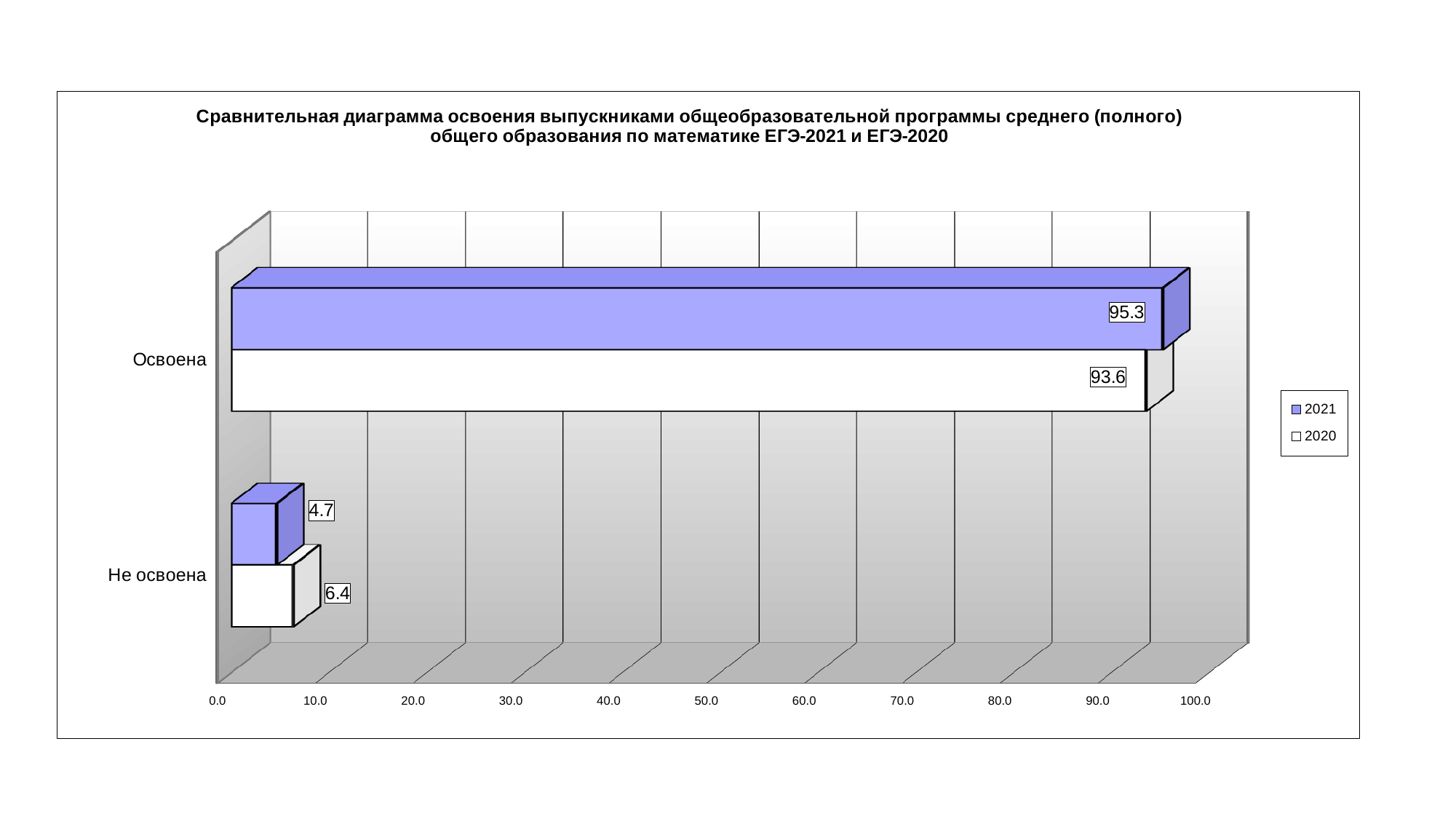
What is the value for 2021 in the "Освоена" category? 95.3 What is the value for 2020 in the "Освоена" category? 93.6 What is the difference between the 2020 and 2021 values in the "Не освоена" category? 1.7 What is the value for 2020 in the "Не освоена" category? 6.4 Which series has the higher value in the "Освоена" category, 2021 or 2020? 2021 What is the value for 2021 in the "Не освоена" category? 4.7 What is the difference between the 2021 and 2020 values in the "Освоена" category? 1.7 Is the 2020 value for "Освоена" greater or less than 90.0? greater Which series has the higher value in the "Не освоена" category, 2021 or 2020? 2020 How many series does the legend list? 2 How many categories are shown on the chart? 2 What kind of chart is shown on the slide? Bar chart